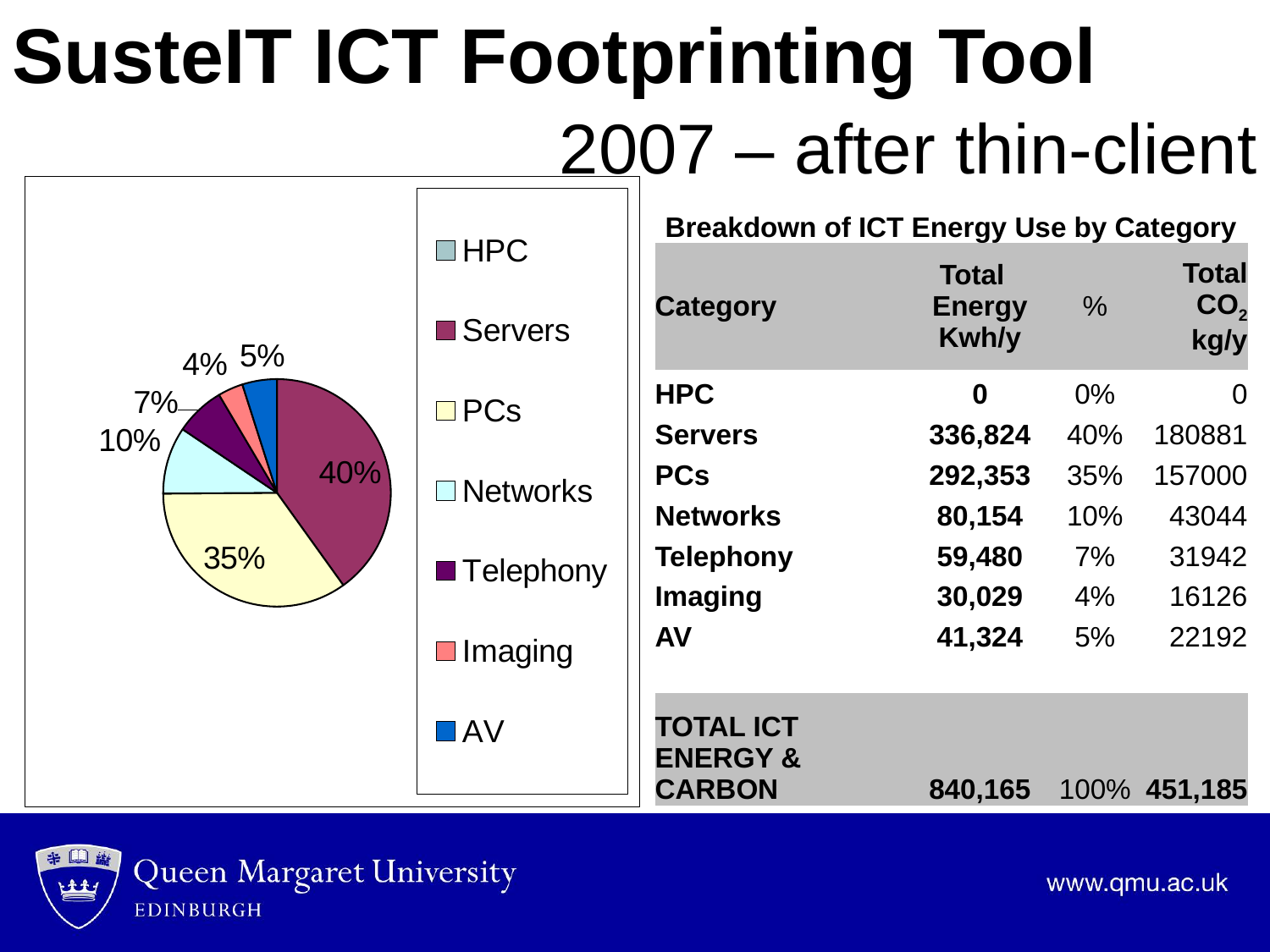
What share of the pie does Networks account for? 10% What colour is the Servers slice in the pie chart? dark red / maroon What share of the pie does PCs account for? 35% Which category has the largest slice of the pie? Servers What kind of chart is shown on the slide? pie chart Which of the labelled slices is the smallest? Imaging What share of the pie does Servers account for? 40% What share of the pie does Telephony account for? 7% How many categories does the legend list? 7 Which slice is larger, Networks or Telephony? Networks What is the difference in percentage points between the Servers slice and the PCs slice? 5% What share of the pie does AV account for? 5%